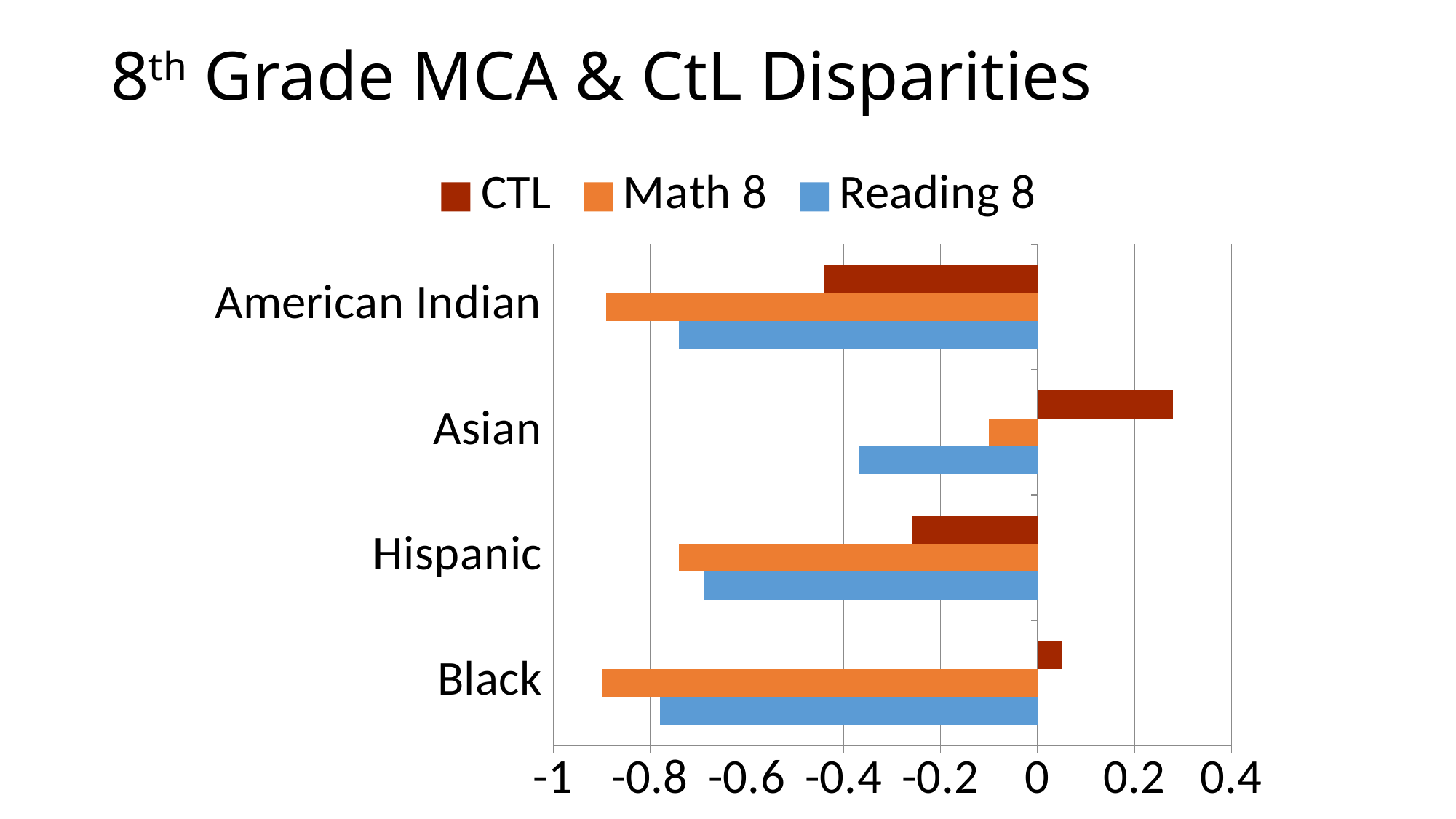
Is the CTL value for Asian larger or smaller than the CTL value for Black? larger How many series does the legend list? 3 Is the CTL value for Hispanic greater or less than -0.2? less Which category has the highest CTL value? Asian Is the Math 8 value for American Indian greater or less than -0.8? less How many categories are shown on the chart? 4 What kind of chart is shown on the slide? bar chart What is the title of the chart on the slide? 8th Grade MCA & CtL Disparities Is the CTL value for Asian greater or less than 0.2? greater Which category has the lowest CTL value? American Indian For American Indian, is the Math 8 value larger or smaller than the Reading 8 value? smaller For the Asian category, which series has the lowest value? Reading 8